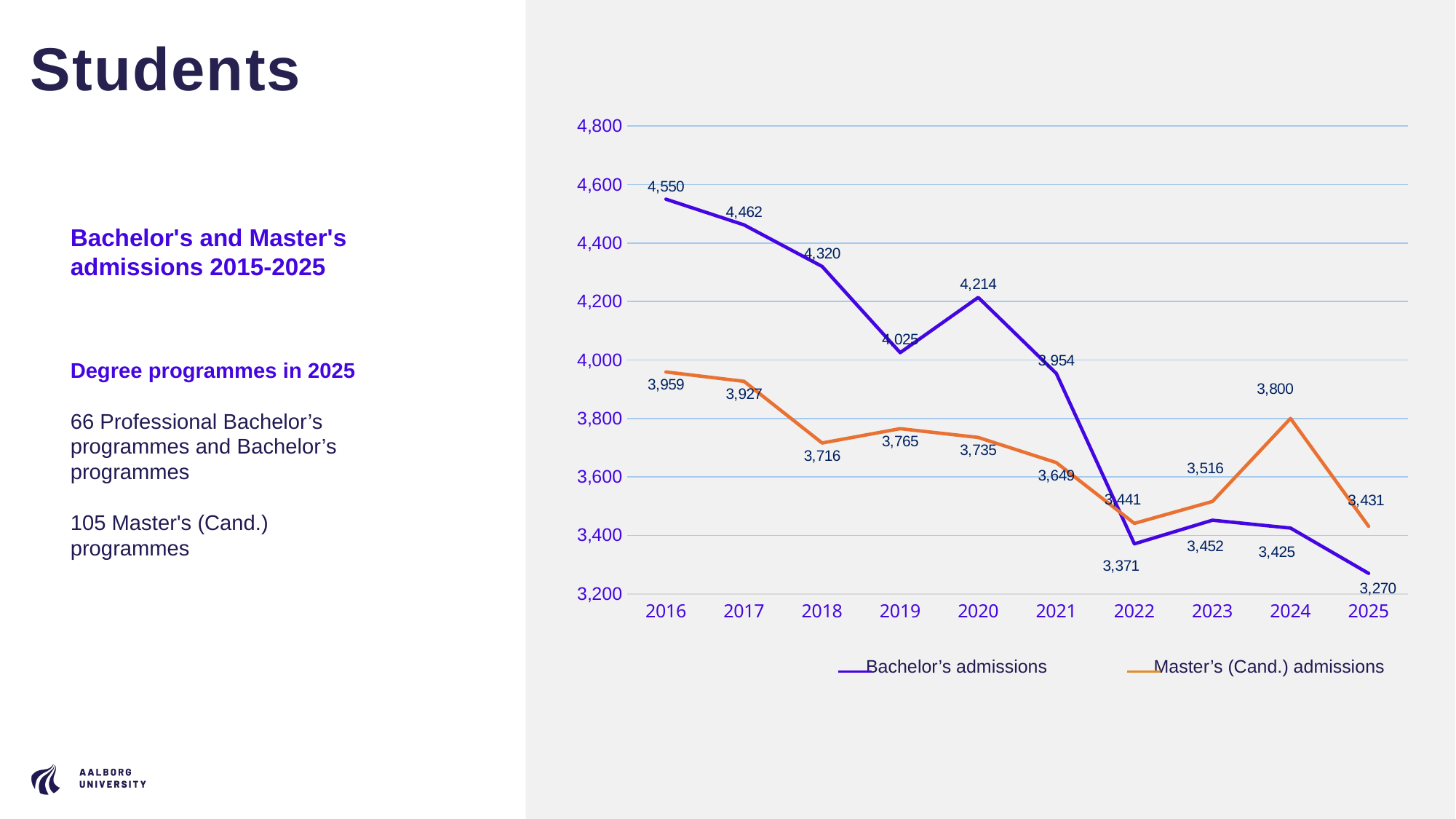
In which year were Master's (Cand.) admissions lowest? 2025 What kind of chart is shown on the slide? Line chart How many series does the legend list? 2 What is the difference between Bachelor's admissions in 2016 and in 2025? 1,280 What was the value for Master's (Cand.) admissions in 2024? 3,800 How many years are shown on the x axis? 10 Did Bachelor's admissions rise or fall between 2016 and 2019? Fall What was the value for Bachelor's admissions in 2025? 3,270 In which year were Bachelor's admissions highest? 2016 What was the value for Bachelor's admissions in 2016? 4,550 Which was larger in 2022: Bachelor's admissions or Master's (Cand.) admissions? Master's (Cand.) admissions Were Bachelor's admissions in 2020 greater or less than 4,000? greater